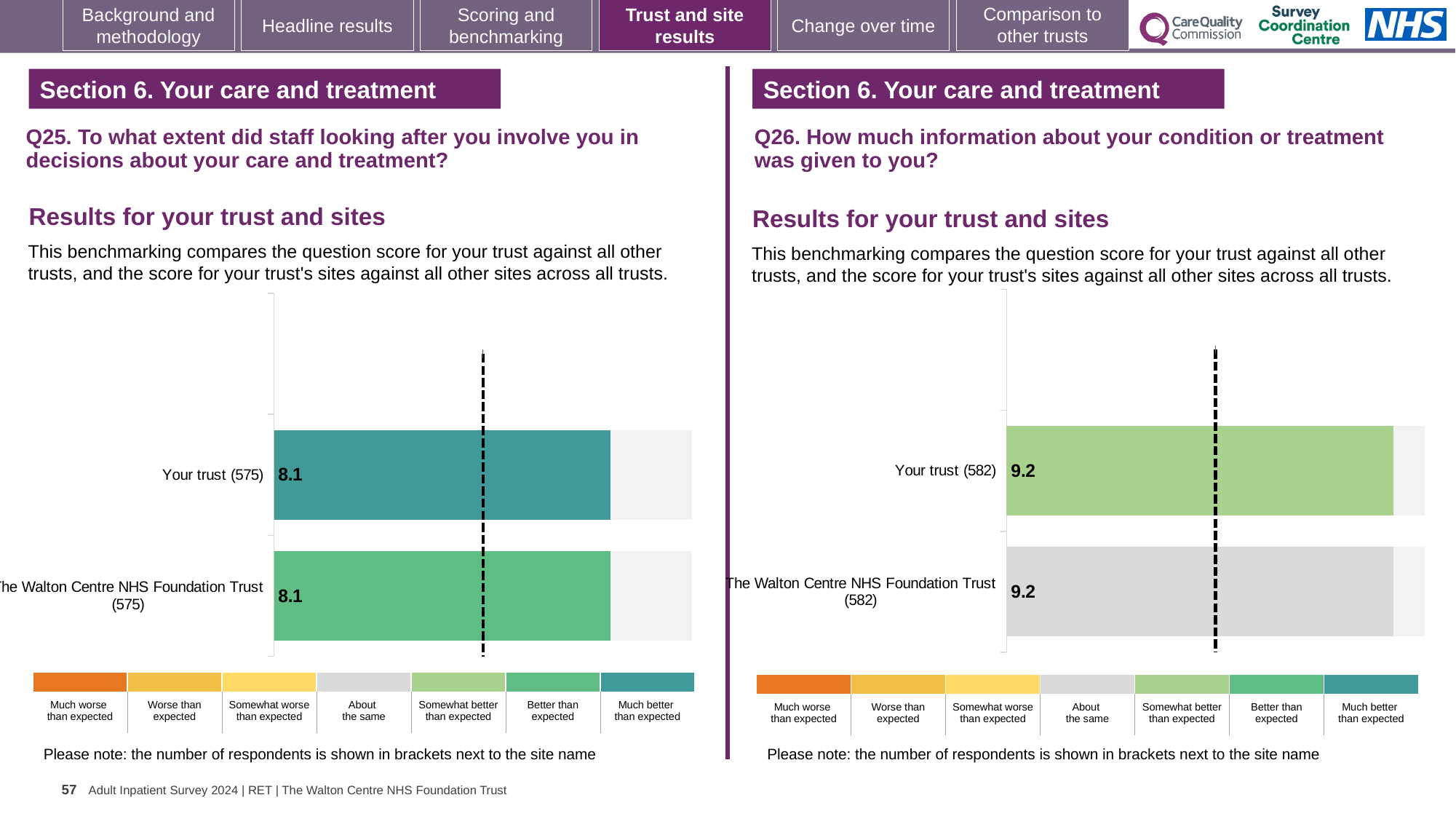
On the Q26 chart (right), how many respondents are shown in brackets for The Walton Centre NHS Foundation Trust? 582 Is the score for Your trust on the Q26 chart (right) larger or smaller than the score for Your trust on the Q25 chart (left)? Larger On the Q25 chart (left), what is the score for The Walton Centre NHS Foundation Trust (575)? 8.1 What kind of chart is used on the Q26 chart (right)? Bar chart On the Q26 chart (right), what is the difference between the score for Your trust and the score for The Walton Centre NHS Foundation Trust? 0 On the Q25 chart (left), what is the difference between the score for Your trust and the score for The Walton Centre NHS Foundation Trust? 0 On the Q25 chart (left), what is the score for Your trust (575)? 8.1 On the Q25 chart (left), how many respondents are shown in brackets for Your trust? 575 How many bars are plotted on the Q25 chart (left)? 2 On the Q26 chart (right), what is the score for The Walton Centre NHS Foundation Trust (582)? 9.2 How many bars are plotted on the Q26 chart (right)? 2 On the Q26 chart (right), what is the score for Your trust (582)? 9.2